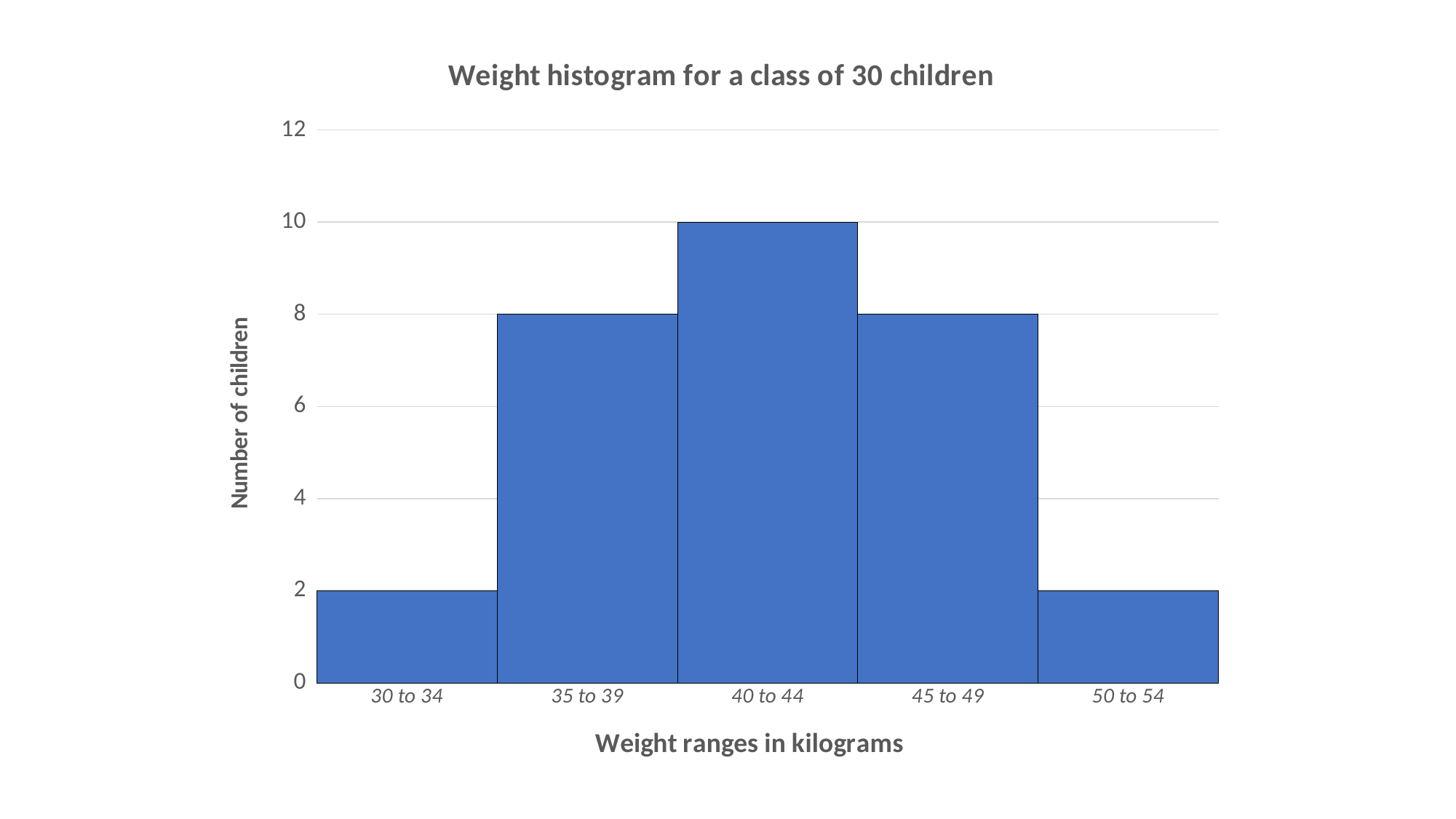
What is the label of the x axis? Weight ranges in kilograms How many more children are in the 40 to 44 range than in the 35 to 39 range? 2 What is the number of children in the 40 to 44 kg weight range? 10 Which has more children, the 35 to 39 range or the 50 to 54 range? 35 to 39 What is the title of the chart? Weight histogram for a class of 30 children Is the number of children in the 40 to 44 range greater or less than 8? greater What is the difference in number of children between the 45 to 49 range and the 50 to 54 range? 6 What kind of chart is shown on the slide? Bar chart (histogram) How many weight ranges are shown on the x axis? 5 What is the number of children in the 30 to 34 kg weight range? 2 Which weight range has the highest number of children? 40 to 44 What is the number of children in the 45 to 49 kg weight range? 8